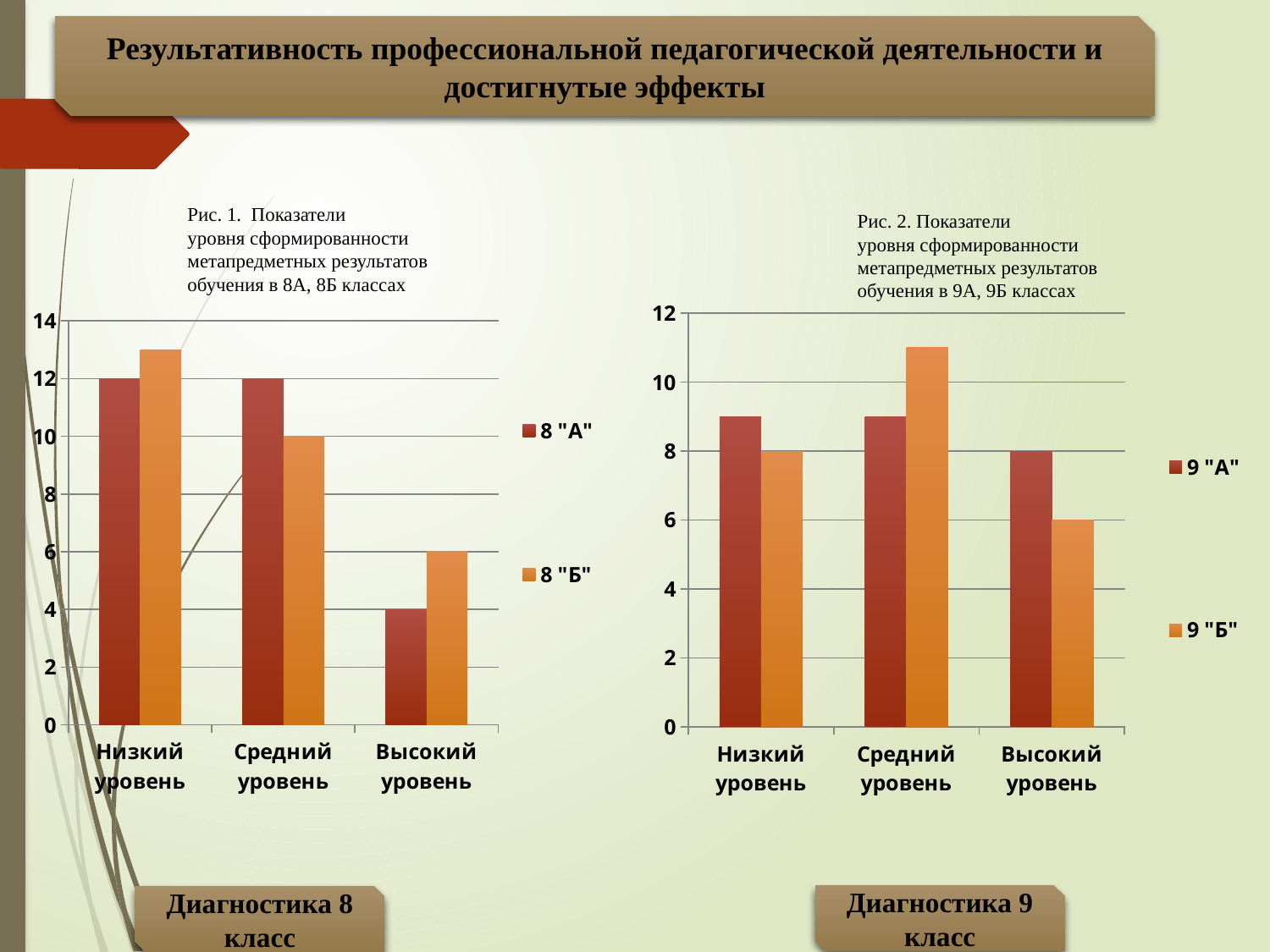
On the right chart (Рис. 2), is the value for 9 "Б" at Средний уровень greater or less than 10? greater On the left chart (Рис. 1), which series has the larger value at Средний уровень, 8 "А" or 8 "Б"? 8 "А" On the left chart (Рис. 1, 8А/8Б classes), what is the value for 8 "А" at Низкий уровень? 12 What type of chart is the right chart (Рис. 2)? Bar chart On the left chart (Рис. 1), how many series does the legend list? 2 On the left chart (Рис. 1), is the value for 8 "Б" at Низкий уровень greater or less than 12? greater On the right chart (Рис. 2, 9А/9Б classes), what is the value for 9 "Б" at Низкий уровень? 8 On the left chart (Рис. 1), what is the value for 8 "Б" at Средний уровень? 10 On the right chart (Рис. 2), which category has the highest value for 9 "Б"? Средний уровень On the left chart (Рис. 1), what is the value for 8 "А" at Высокий уровень? 4 On the left chart (Рис. 1), what is the difference between 8 "Б" and 8 "А" at Высокий уровень? 2 On the right chart (Рис. 2), what is the value for 9 "Б" at Высокий уровень? 6